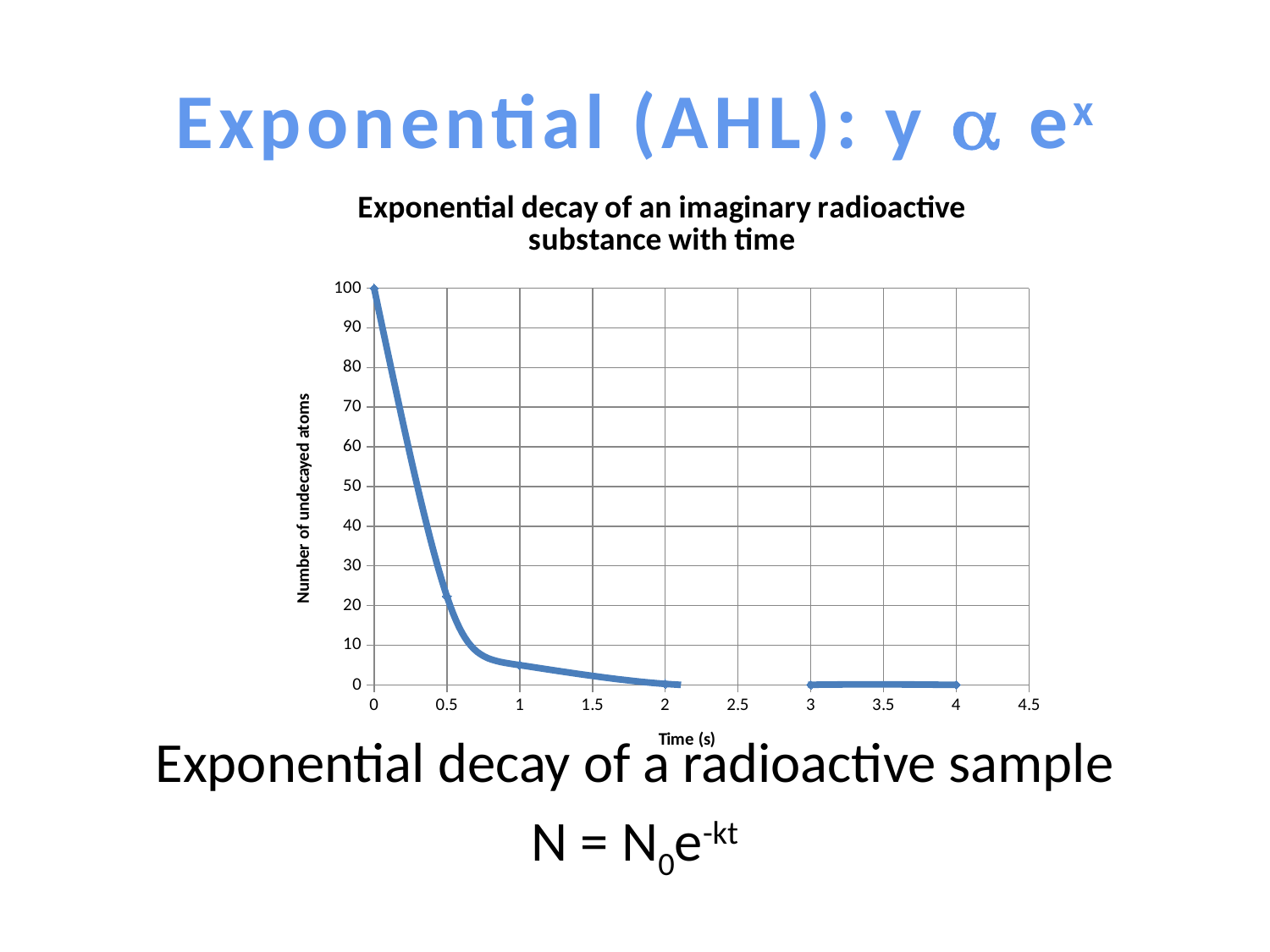
What kind of chart is shown on the slide? line chart What is the highest value shown on the vertical axis? 100 Is the number of undecayed atoms at 0.5 s greater or less than 10? greater Does the number of undecayed atoms rise or fall as time increases? fall At what time is the number of undecayed atoms highest? 0 Is the number of undecayed atoms at 1 s greater or less than 10? less What is the title of the chart? Exponential decay of an imaginary radioactive substance with time Which is larger, the number of undecayed atoms at 0.5 s or at 1 s? 0.5 s What is the label of the vertical axis of the chart? Number of undecayed atoms Is the number of undecayed atoms at 0.5 s greater or less than 30? less What is the number of undecayed atoms at time 0 s? 100